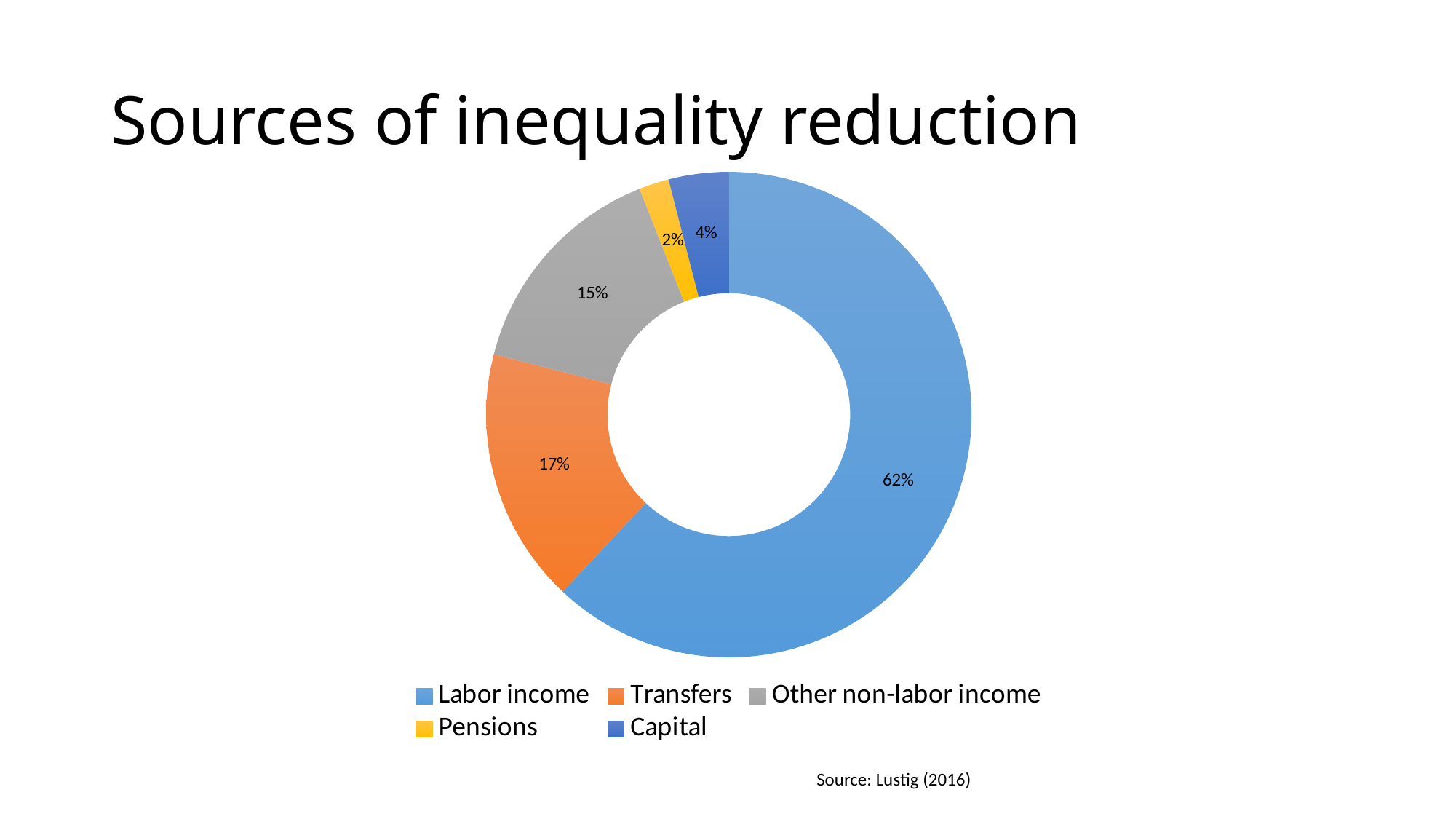
What share of inequality reduction comes from Pensions? 2% What is the difference in percentage points between the Labor income share and the Transfers share? 45 What share of inequality reduction comes from Labor income? 62% What kind of chart is shown on the slide? Doughnut (pie) chart What share of inequality reduction comes from Capital? 4% Which source accounts for the largest share of inequality reduction? Labor income How many categories does the chart show? 5 Which source accounts for the smallest share of inequality reduction? Pensions What is the title of the slide? Sources of inequality reduction What share of inequality reduction comes from Other non-labor income? 15% Which is larger, the share for Capital or the share for Pensions? Capital What share of inequality reduction comes from Transfers? 17%